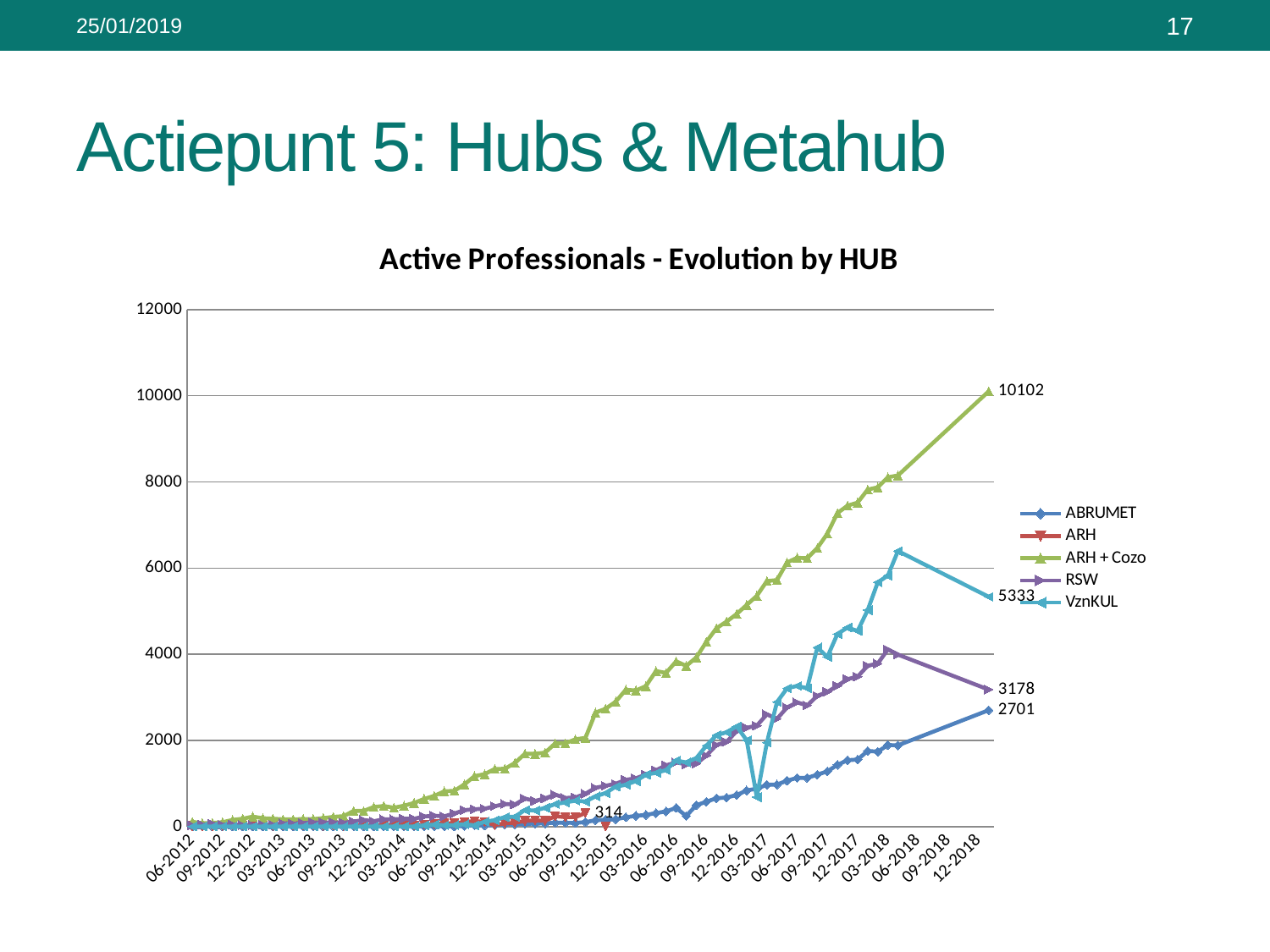
What is the final labelled value for the ABRUMET series? 2701 What kind of chart is shown on the slide? line chart What is the last labelled value for the ARH series? 314 What is the final labelled value for the RSW series? 3178 What is the final labelled value for the ARH + Cozo series? 10102 How many series does the chart legend list? 5 What is the difference between the final labelled values of ARH + Cozo and VznKUL? 4769 Which series has the highest value at the end of the chart (12-2018)? ARH + Cozo Does the ARH + Cozo series generally rise or fall from 06-2012 to 12-2018? rise What is the final labelled value for the VznKUL series? 5333 Which is larger at 12-2018, the RSW value or the ABRUMET value? RSW What is the title of the chart? Active Professionals - Evolution by HUB